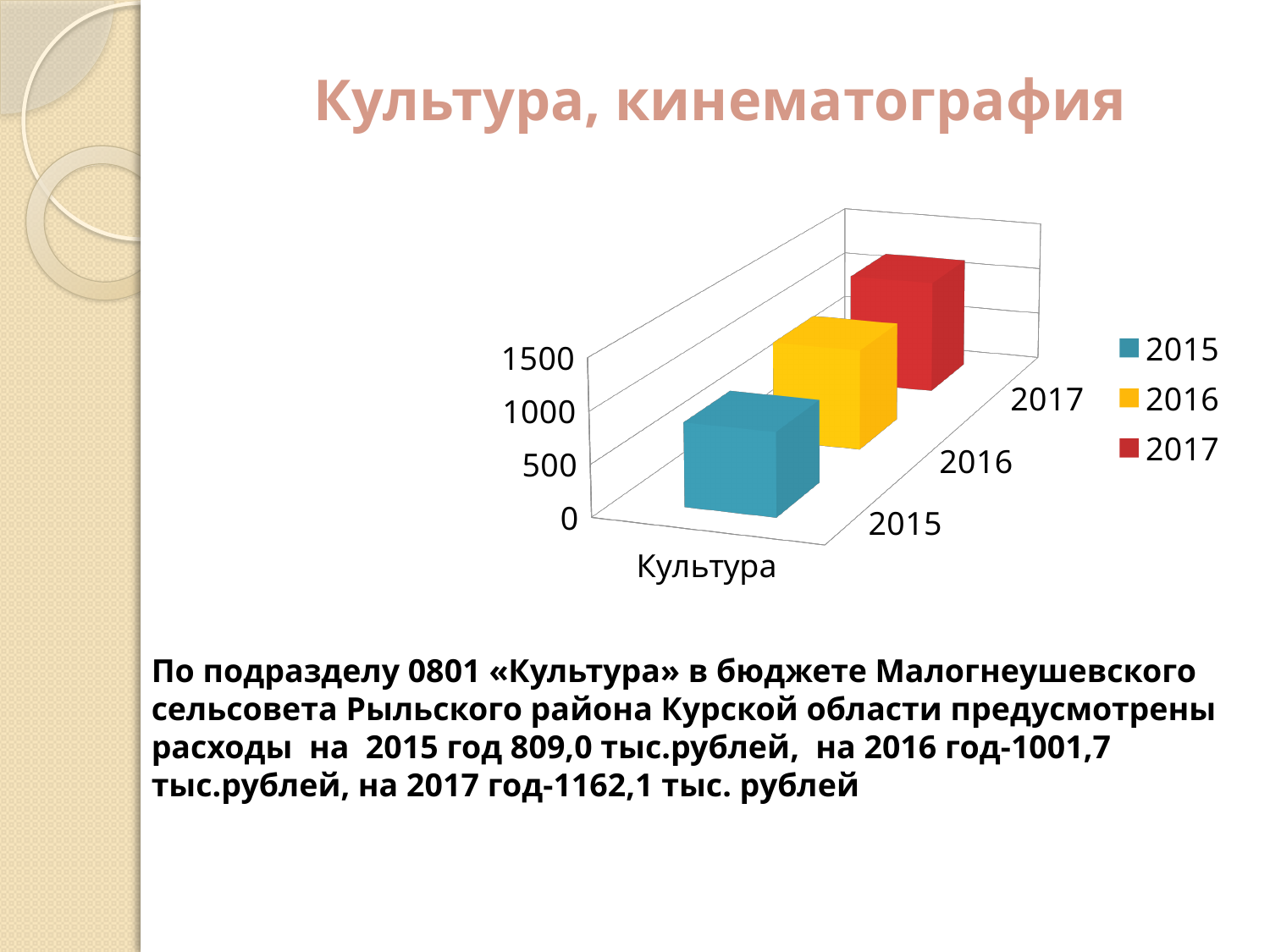
What is the name of the category shown on the chart's horizontal axis? Культура What kind of chart is shown on the slide? bar chart Which year has the lowest bar in the chart? 2015 Which year has the highest bar in the chart? 2017 How many series does the chart legend list? 3 According to the slide, what are the planned expenditures on Культура for 2016? 1001,7 тыс.рублей How many categories are shown on the chart's category axis? 1 What colour is the bar for 2017 in the chart? red Which is larger, the bar for 2016 or the bar for 2015? 2016 Do the values rise or fall from 2015 to 2017? rise Is the bar for 2015 greater or less than 1000? less Is the bar for 2017 greater or less than 1000? greater